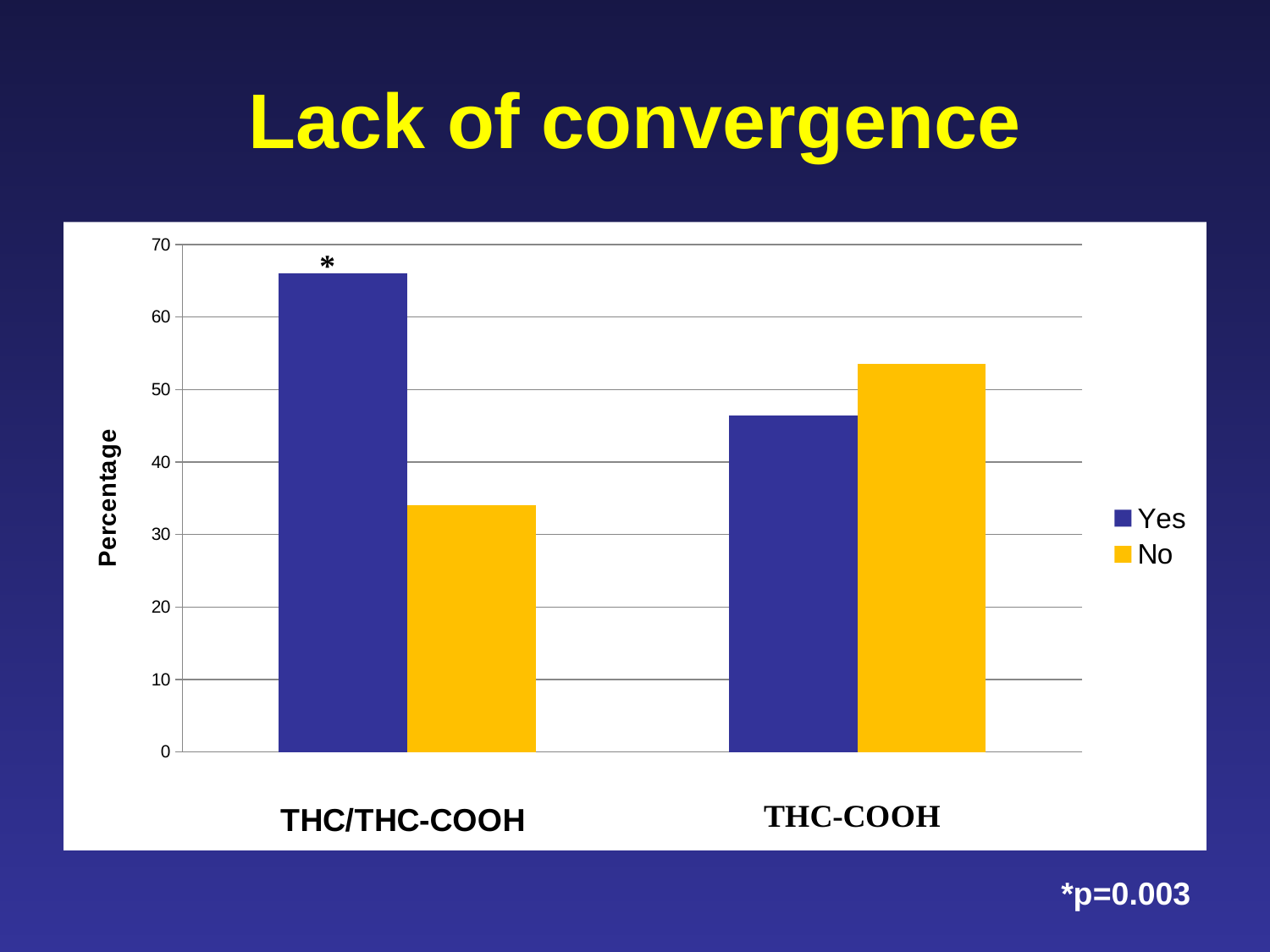
Which bar is the tallest in the chart? Yes for THC/THC-COOH How many categories are shown on the x axis? 2 Is the No value for THC-COOH greater or less than 50? greater What kind of chart is shown on the slide? bar chart How many series does the legend list? 2 Which series has the higher value for THC-COOH, Yes or No? No Is the Yes value for THC/THC-COOH greater or less than 60? greater Is the Yes value for THC-COOH greater or less than 50? less Which series has the higher value for THC/THC-COOH, Yes or No? Yes Which bar is the shortest in the chart? No for THC/THC-COOH What is the label on the y axis? Percentage